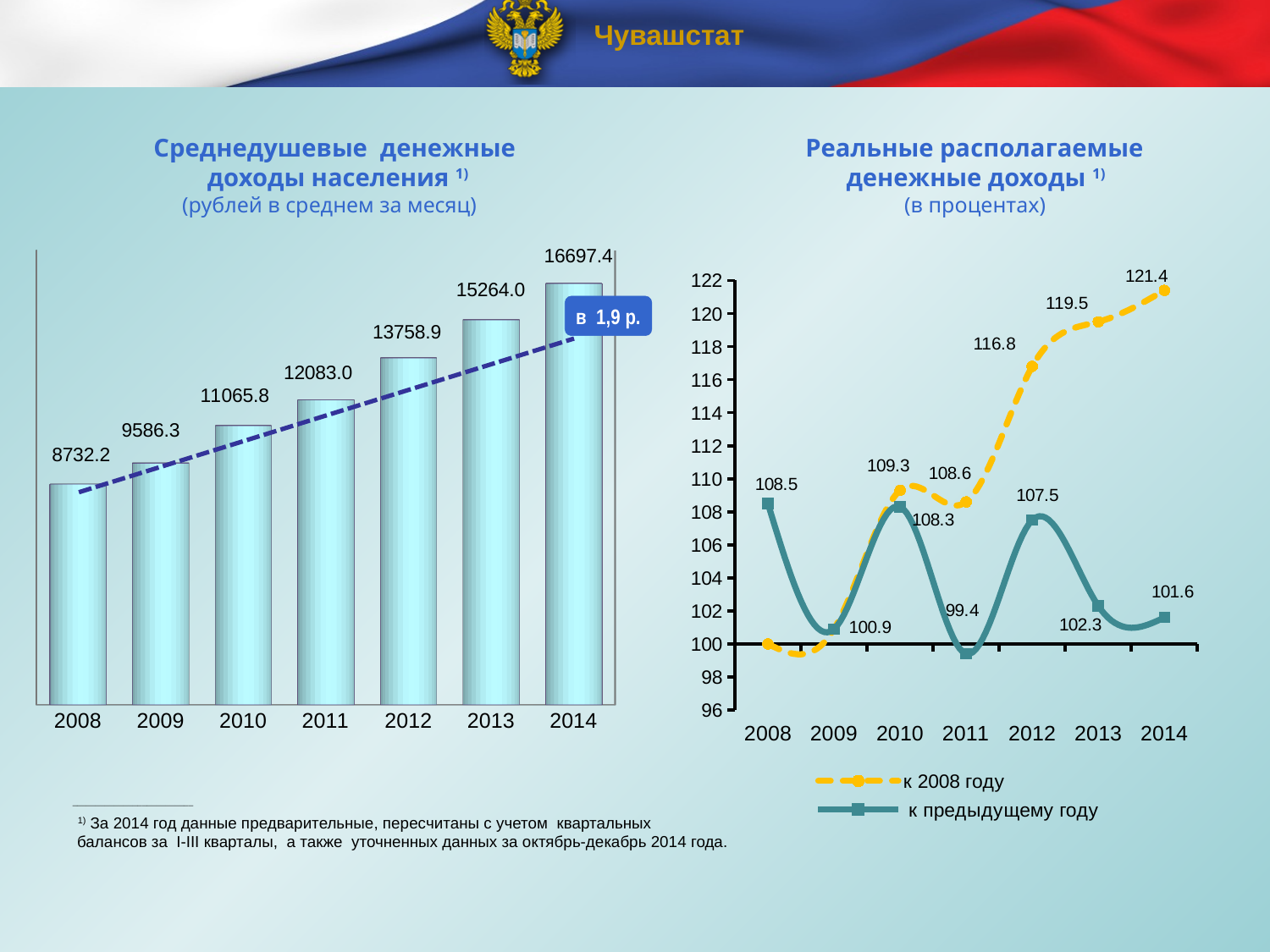
On the left chart (Среднедушевые денежные доходы населения), what is the value for 2014? 16697.4 On the left chart (Среднедушевые денежные доходы населения), do the values rise or fall from 2008 to 2014? rise On the left chart (Среднедушевые денежные доходы населения), how many years are shown? 7 On the left chart (Среднедушевые денежные доходы населения), what is the difference between the 2014 and 2013 values? 1433.4 On the right chart (Реальные располагаемые денежные доходы), how many series does the legend list? 2 On the right chart (Реальные располагаемые денежные доходы), what is the value of the 'к 2008 году' series for 2014? 121.4 On the left chart (Среднедушевые денежные доходы населения), which year has the lowest value? 2008 On the right chart (Реальные располагаемые денежные доходы), what is the value of the 'к предыдущему году' series for 2011? 99.4 On the left chart (Среднедушевые денежные доходы населения), what is the value for 2010? 11065.8 On the right chart (Реальные располагаемые денежные доходы), which year has the highest value in the 'к предыдущему году' series? 2008 On the right chart (Реальные располагаемые денежные доходы), which is larger for 2012: the 'к 2008 году' value or the 'к предыдущему году' value? к 2008 году What kind of chart is the left chart (Среднедушевые денежные доходы населения)? bar chart